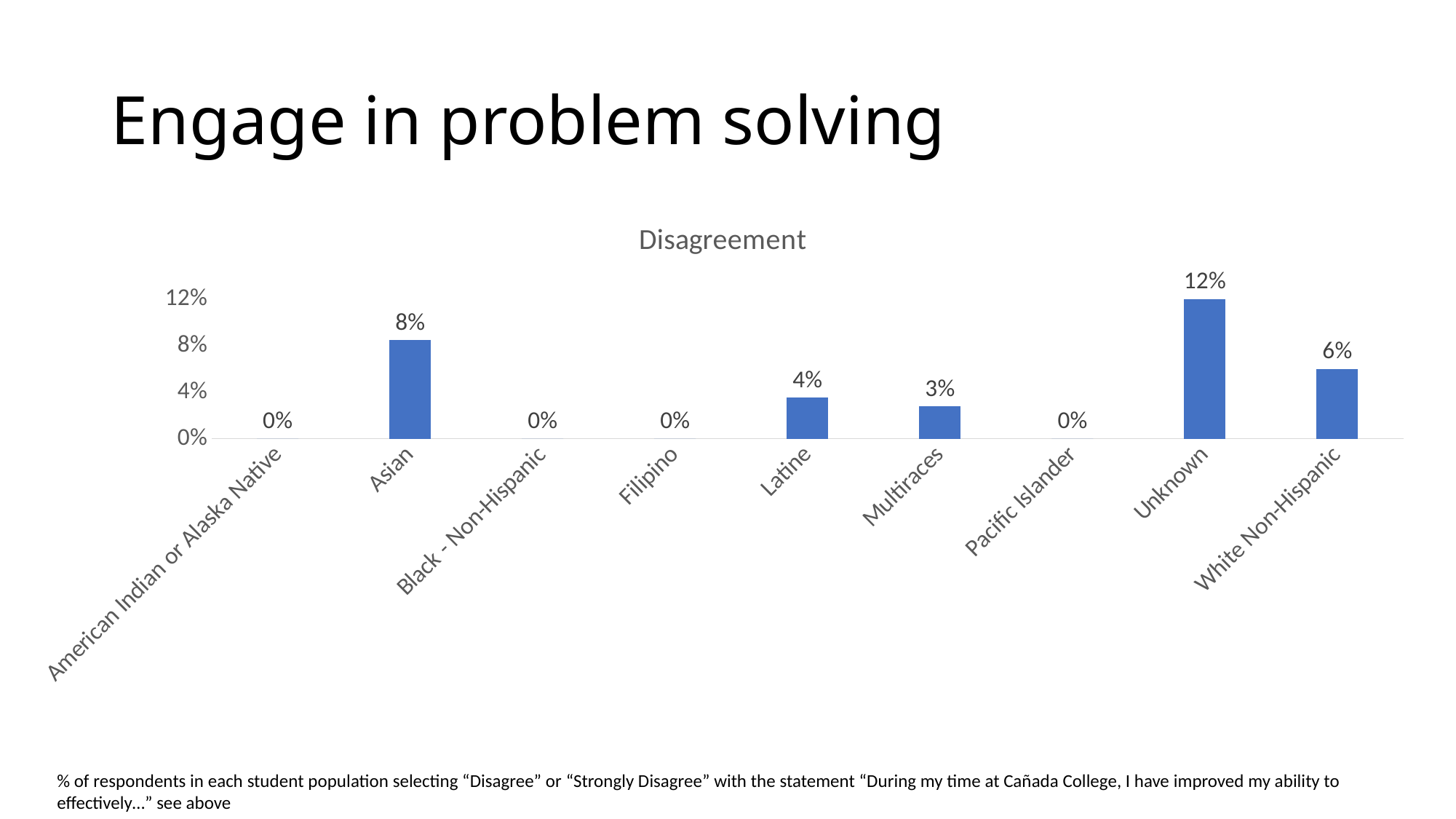
What is the difference between the disagreement values for Unknown and Asian? 4% What is the disagreement value for Multiraces? 3% What is the disagreement value for White Non-Hispanic? 6% How many categories have a disagreement value of 0%? 4 What kind of chart is shown on the slide? Bar chart What is the disagreement value for Unknown? 12% What is the disagreement value for Asian? 8% What is the disagreement value for Latine? 4% What is the title of the chart? Disagreement Which category has the highest disagreement value? Unknown How many categories are shown on the x axis of the chart? 9 Which has a larger disagreement value, Latine or Multiraces? Latine